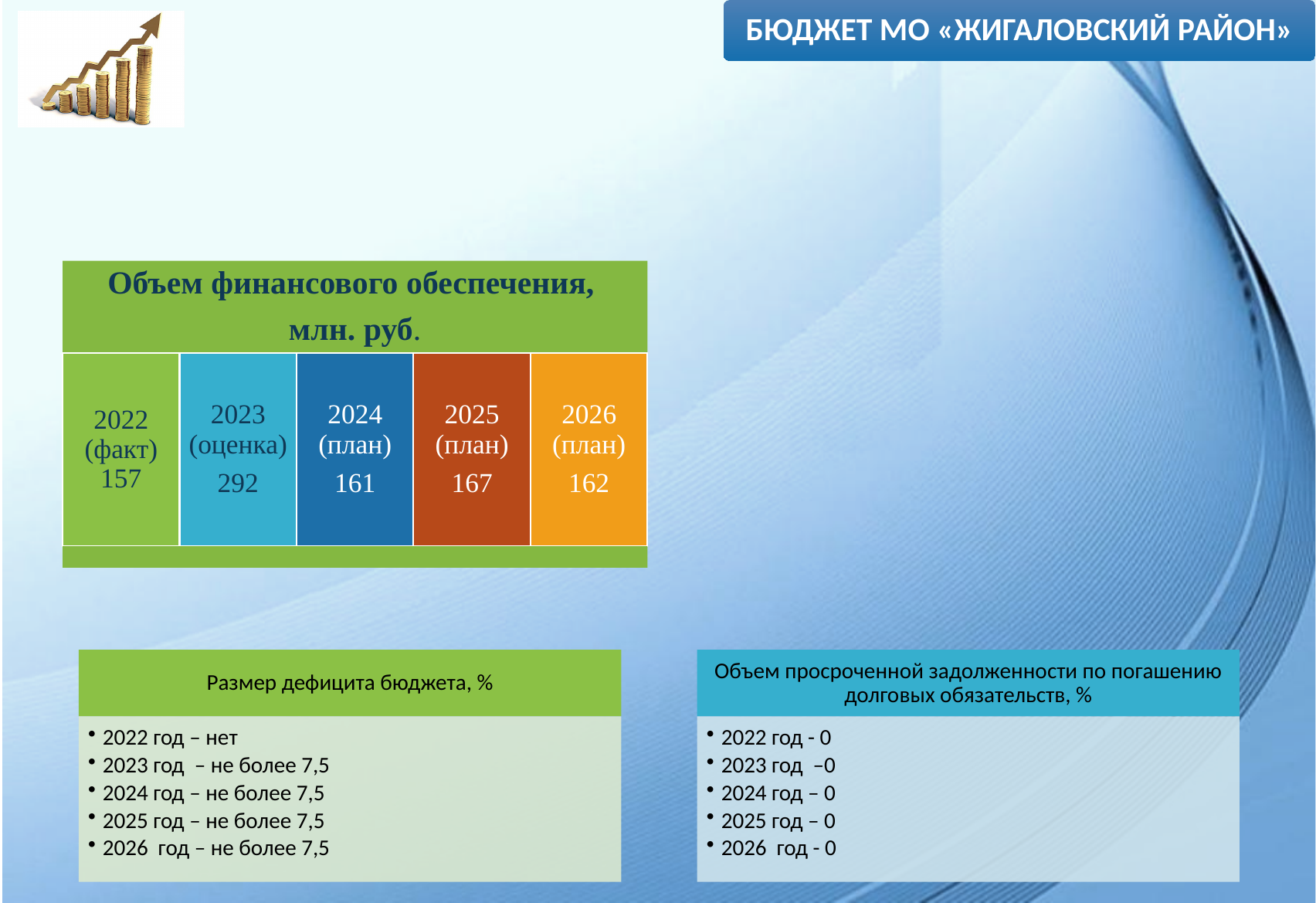
In the 'Объем финансового обеспечения, млн. руб.' graphic, what colour is the block for 2025 (план)? Red-brown (dark orange) In the 'Объем финансового обеспечения, млн. руб.' graphic, which year has the highest value? 2023 (оценка) What unit is stated in the title of the 'Объем финансового обеспечения' graphic? млн. руб. In the 'Объем финансового обеспечения, млн. руб.' graphic, which is larger: the value for 2024 (план) or the value for 2026 (план)? 2026 (план) In the 'Объем финансового обеспечения, млн. руб.' graphic, what is the value for 2025 (план)? 167 In the 'Объем финансового обеспечения, млн. руб.' graphic, what is the difference between the 2025 (план) value and the 2024 (план) value? 6 In the 'Объем финансового обеспечения, млн. руб.' graphic, what is the value for 2023 (оценка)? 292 In the 'Объем финансового обеспечения, млн. руб.' graphic, which year has the lowest value? 2022 (факт) How many years are shown in the 'Объем финансового обеспечения, млн. руб.' graphic? 5 In the 'Объем финансового обеспечения, млн. руб.' graphic, what is the value for 2026 (план)? 162 In the 'Объем финансового обеспечения, млн. руб.' graphic, what is the value for 2022 (факт)? 157 In the 'Объем финансового обеспечения, млн. руб.' graphic, what is the difference between the 2023 (оценка) value and the 2022 (факт) value? 135